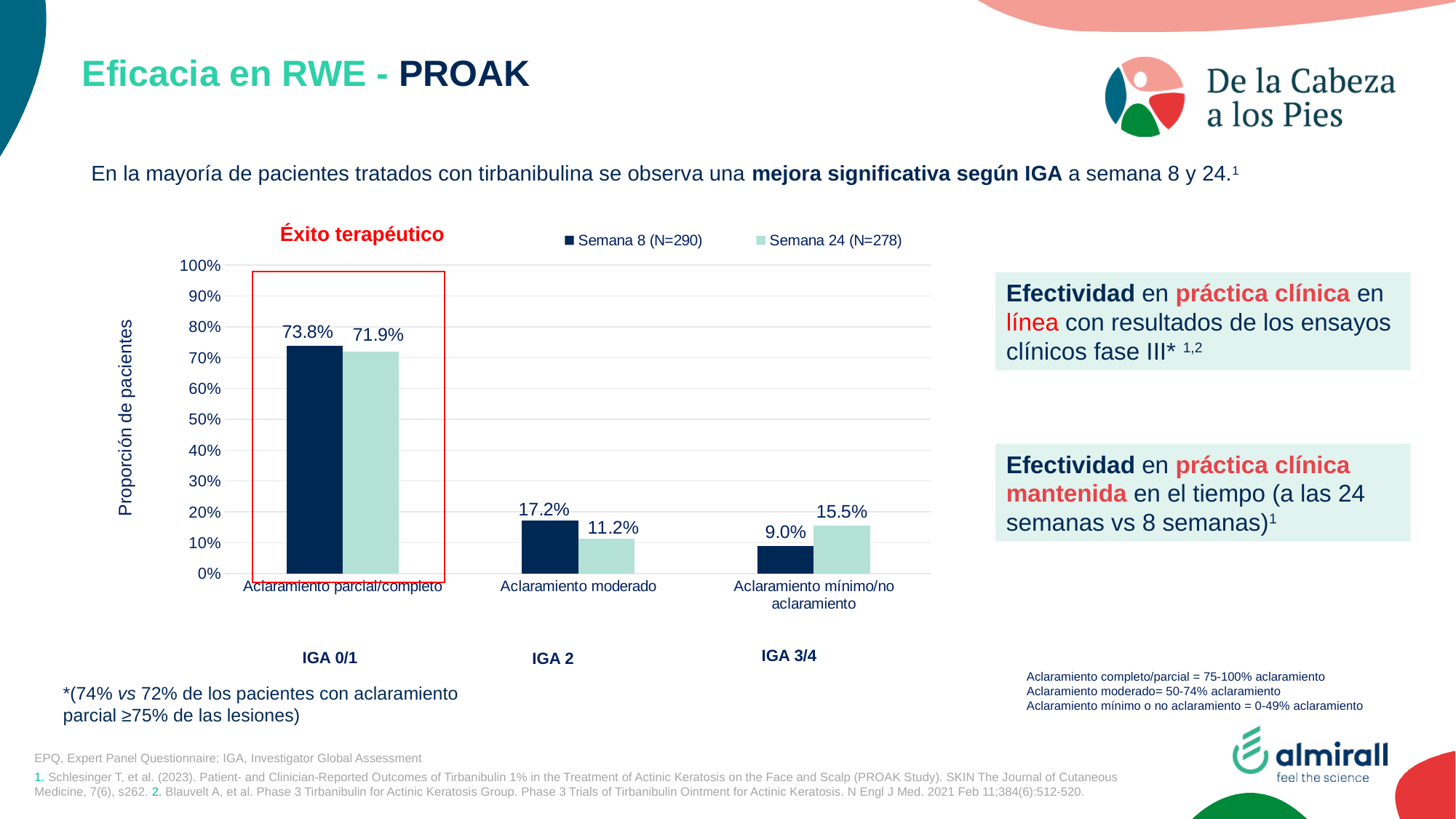
What is the Semana 24 (N=278) value for Aclaramiento moderado? 11.2% How many series does the chart legend list? 2 Which category has the highest Semana 24 (N=278) value? Aclaramiento parcial/completo What is the Semana 24 (N=278) value for Aclaramiento mínimo/no aclaramiento? 15.5% Which category has the lowest Semana 8 (N=290) value? Aclaramiento mínimo/no aclaramiento What is the difference between the Semana 8 and Semana 24 values for Aclaramiento moderado? 6.0% For Aclaramiento mínimo/no aclaramiento, which series has the larger value, Semana 8 (N=290) or Semana 24 (N=278)? Semana 24 (N=278) What type of chart is shown on the slide? Bar chart What is the Semana 8 (N=290) value for Aclaramiento parcial/completo? 73.8% How many categories are shown on the x axis of the chart? 3 What is the label of the y axis of the chart? Proporción de pacientes What is the Semana 8 (N=290) value for Aclaramiento mínimo/no aclaramiento? 9.0%